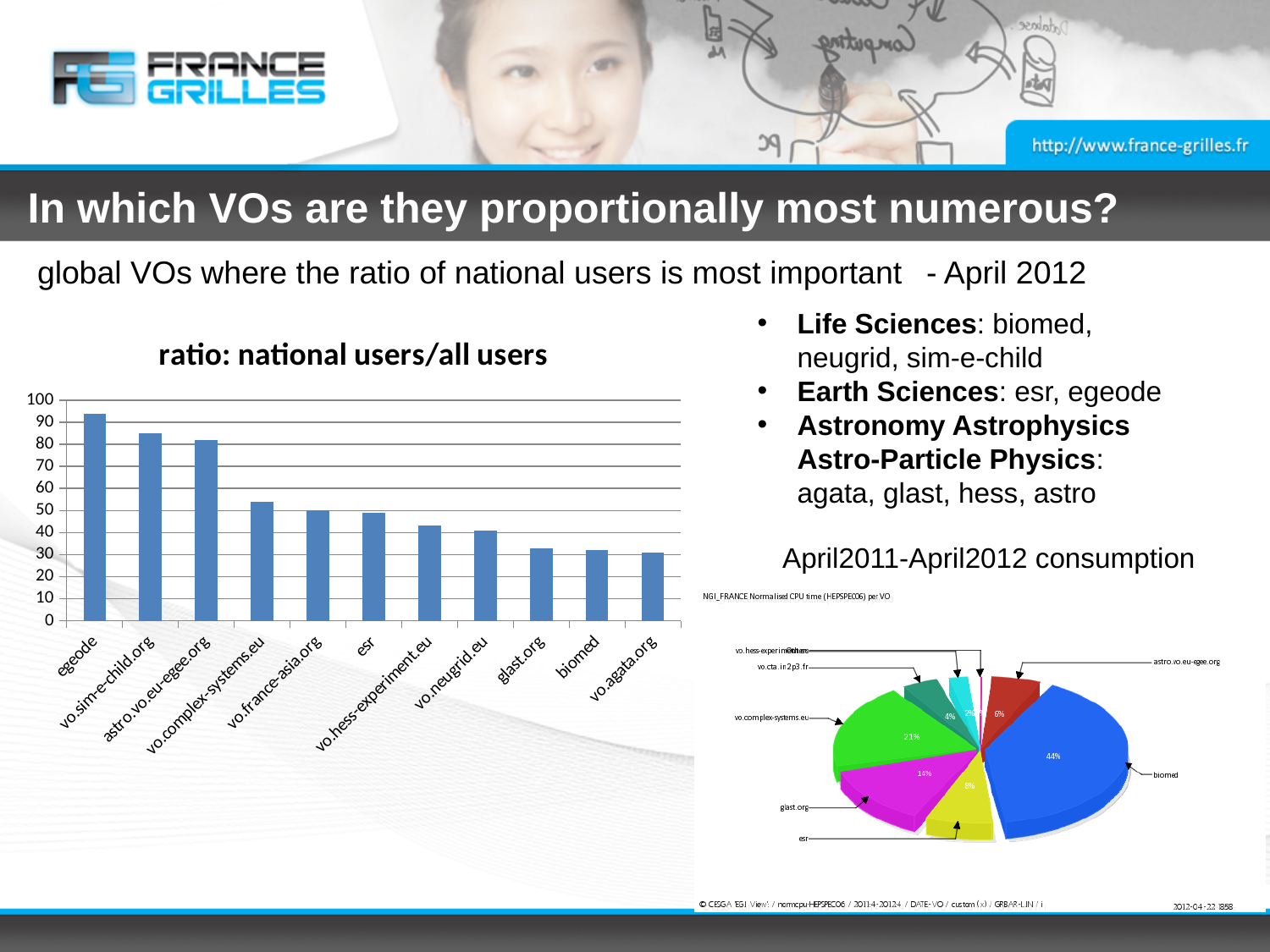
In the 'ratio: national users/all users' bar chart, is the value for glast.org greater or less than 40? less How many VOs are shown on the x axis of the 'ratio: national users/all users' bar chart? 11 In the 'ratio: national users/all users' bar chart, is the value for vo.complex-systems.eu greater or less than 50? greater What kind of chart is the 'ratio: national users/all users' chart on the left of the slide? bar chart In the 'April2011-April2012 consumption' pie chart, what share does vo.complex-systems.eu have? 21% What kind of chart is the 'April2011-April2012 consumption' chart on the right of the slide? pie chart In the 'ratio: national users/all users' bar chart, which has the larger value, vo.sim-e-child.org or vo.france-asia.org? vo.sim-e-child.org In the 'ratio: national users/all users' bar chart, is the value for vo.neugrid.eu greater or less than 50? less In the 'ratio: national users/all users' bar chart, which VO has the highest ratio? egeode In the 'April2011-April2012 consumption' pie chart, what share does biomed have? 44% In the 'ratio: national users/all users' bar chart, do the values rise or fall from left to right along the x axis? fall